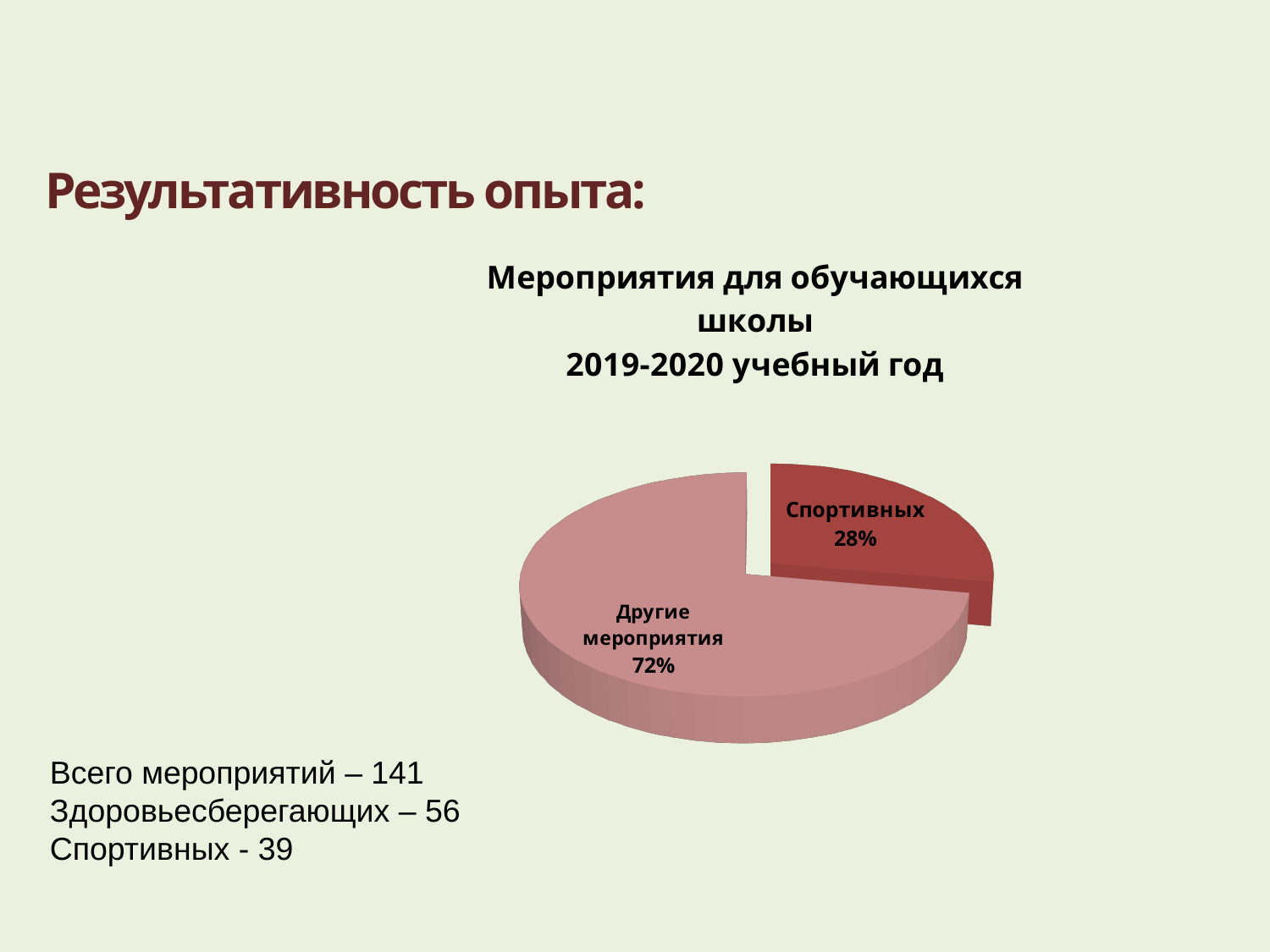
Which slice of the pie is the smallest? Спортивных What share of the pie does the "Другие мероприятия" slice represent? 72% What is the title of the chart? Мероприятия для обучающихся школы 2019-2020 учебный год How many slices does the pie chart have? 2 What is the difference in percentage points between the "Другие мероприятия" slice and the "Спортивных" slice? 44% What kind of chart is shown on the slide? Pie chart Is the share of the "Спортивных" slice greater or less than 50%? less Which is larger: the "Спортивных" slice or the "Другие мероприятия" slice? Другие мероприятия Which slice of the pie is shown in the darker red colour? Спортивных Which slice of the pie is the largest? Другие мероприятия What share of the pie does the "Спортивных" slice represent? 28%